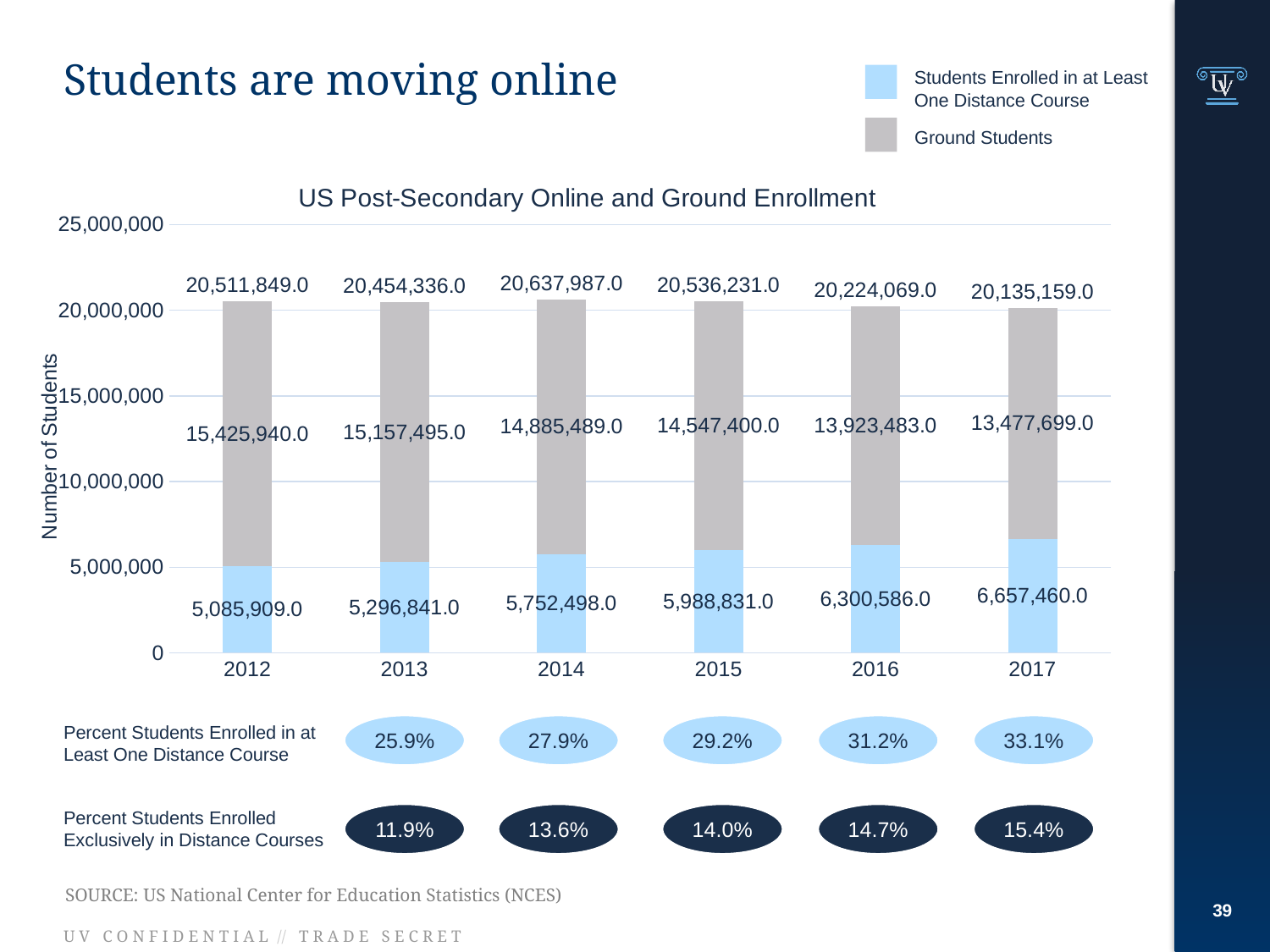
What kind of chart is shown on the slide? Stacked bar chart What is the title of the chart? US Post-Secondary Online and Ground Enrollment What is the total enrollment shown above the bar for 2017? 20,135,159.0 Do the values for Ground Students rise or fall from 2012 to 2017? Fall Which year has the lowest number of Ground Students? 2017 What is the number of Students Enrolled in at Least One Distance Course in 2014? 5,752,498.0 Which year has the highest number of Students Enrolled in at Least One Distance Course? 2017 Which is larger: the number of Ground Students in 2012 or in 2015? 2012 What is the difference between the number of Students Enrolled in at Least One Distance Course in 2017 and in 2012? 1,571,551.0 How many series does the legend list? 2 How many years are shown on the x axis of the chart? 6 What is the number of Ground Students in 2016? 13,923,483.0